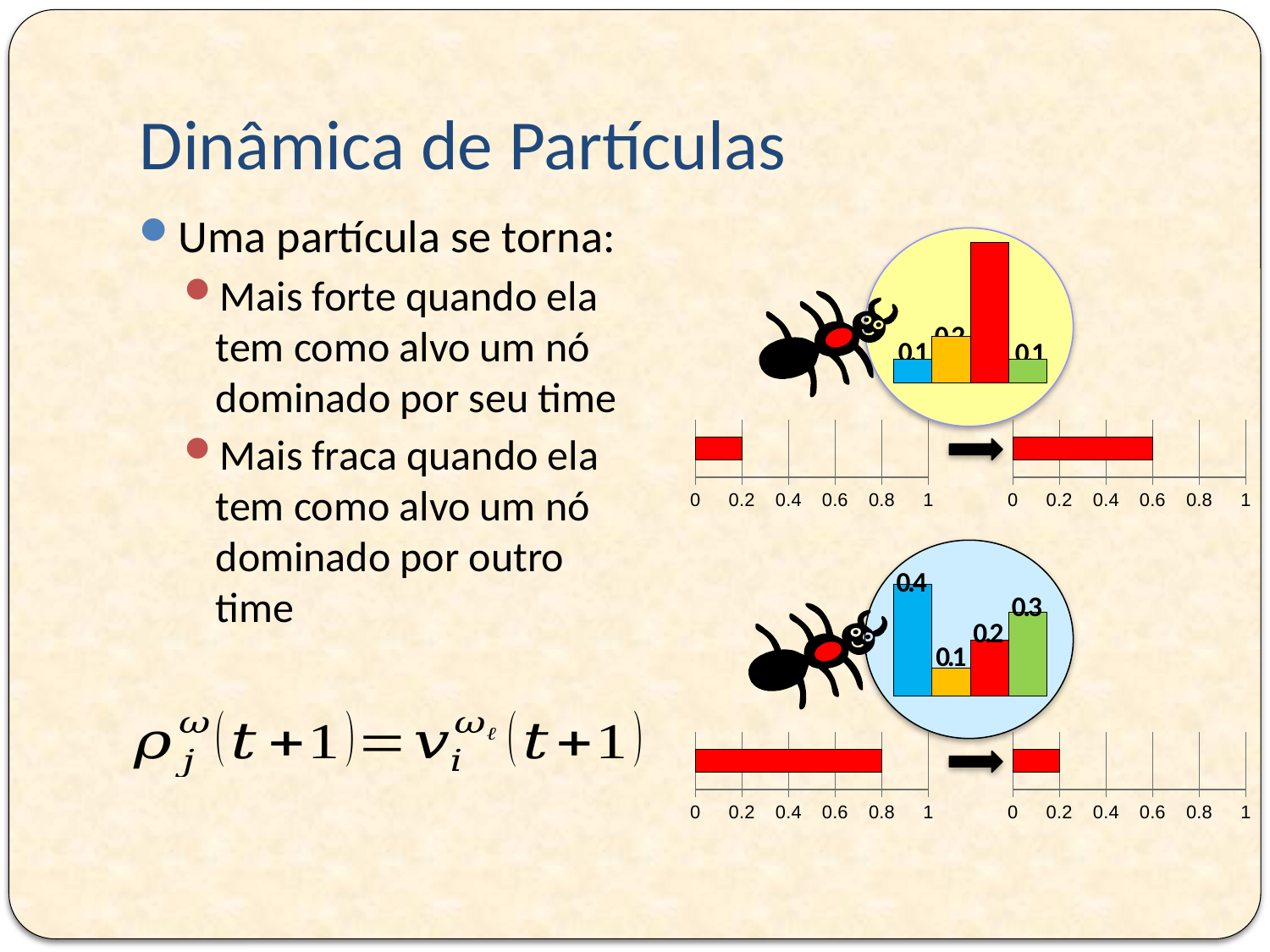
In the bar chart inside the top yellow circle, which bar is the highest? the red bar In the bar chart inside the top yellow circle, what is the value of the blue bar? 0.1 What kind of chart is shown inside the bottom blue circle? bar chart In the bar chart inside the bottom blue circle, which is larger, the red bar or the green bar? the green bar In the bar chart inside the bottom blue circle, which bar is the lowest? the orange bar In the bar chart inside the top yellow circle, what is the value of the orange bar? 0.2 In the bar chart inside the bottom blue circle, what is the value of the green bar? 0.3 In the bottom row of horizontal gauges, at what value does the red bar on the left-hand gauge (before the arrow) end? 0.8 In the bar chart inside the bottom blue circle, what is the value of the blue bar? 0.4 In the bar chart inside the bottom blue circle, what is the difference between the blue bar and the orange bar? 0.3 How many bars are in the bar chart inside the top yellow circle? 4 In the top row of horizontal gauges, at what value does the red bar on the right-hand gauge (after the arrow) end? 0.6